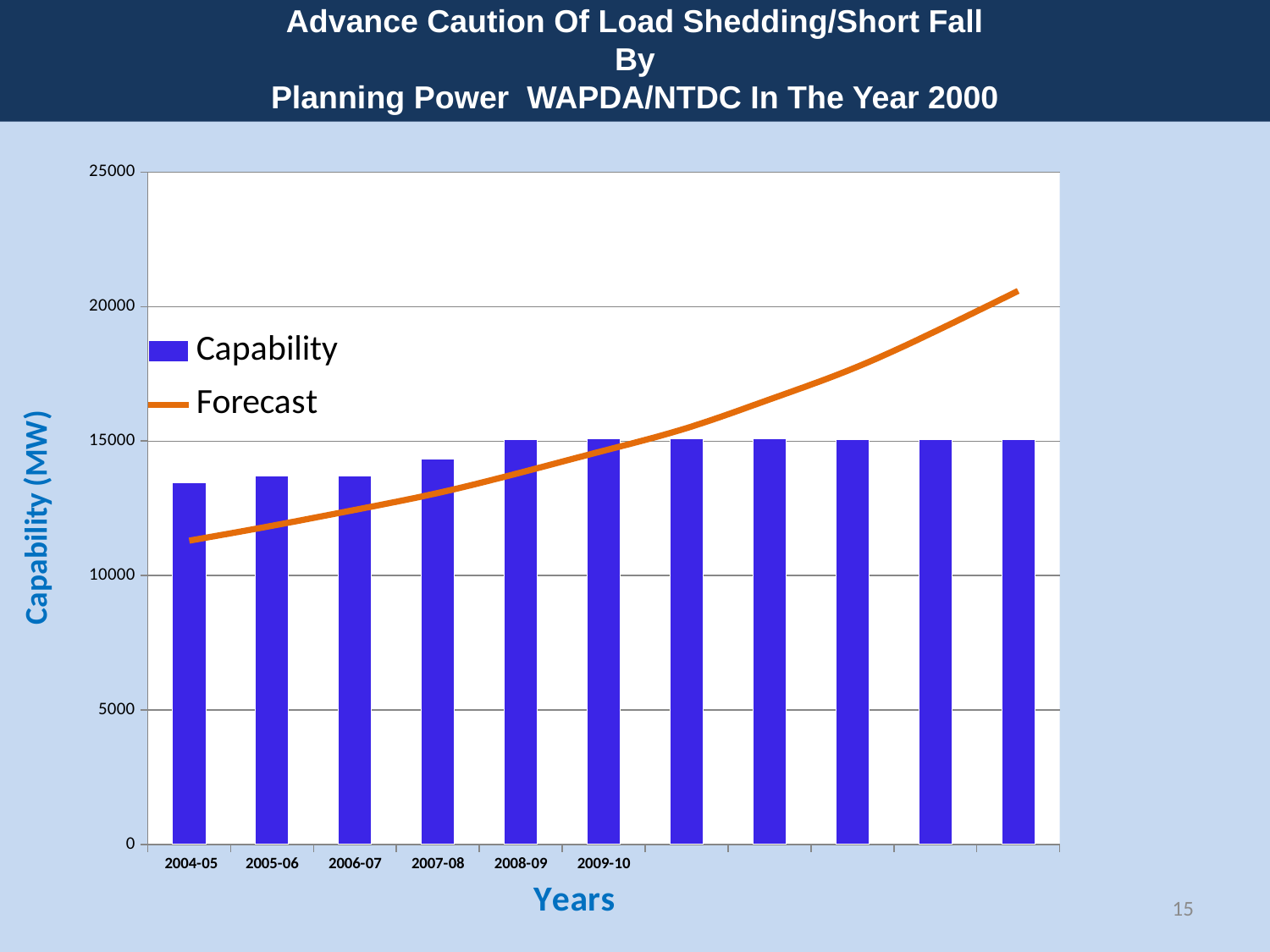
How many series does the legend list? 2 Is the Forecast value at 2004-05 greater or less than 15000? less What are the two series named in the legend? Capability and Forecast Does the Forecast line rise or fall from left to right across the years? rises Is the Forecast value at the right end of the line greater or less than 20000? greater Which is larger, the Capability bar for 2007-08 or for 2004-05? 2007-08 Is the Capability value for 2004-05 greater or less than 15000? less Which labelled year has the lowest Capability bar? 2004-05 How many Capability bars are plotted on the chart? 11 What kind of chart is used to show the Capability series? Bar chart What is the title of the vertical axis? Capability (MW)